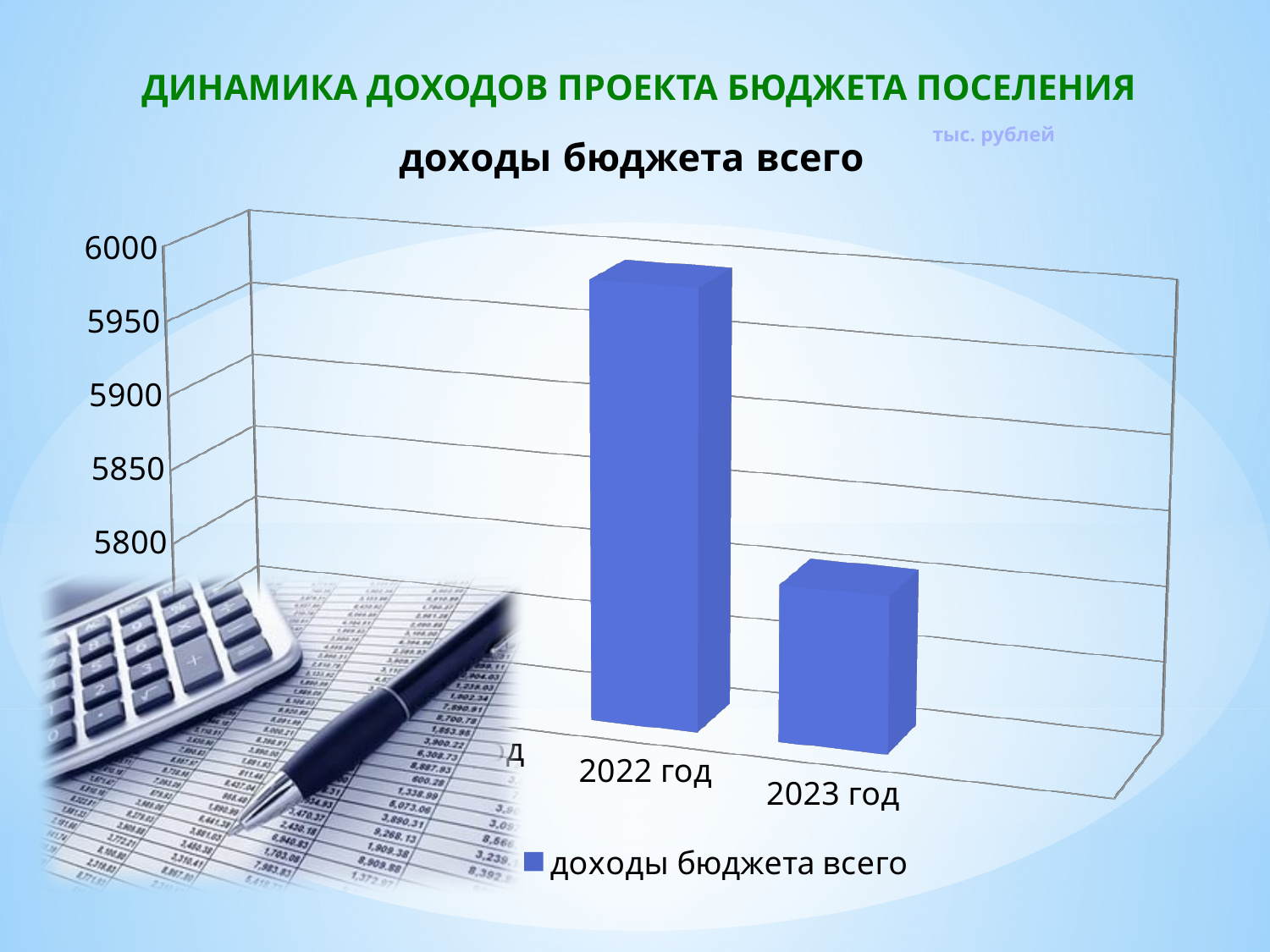
What kind of chart is shown on the slide? bar chart Which is larger, the value for 2022 год or the value for 2023 год? 2022 год How many series does the legend list? 1 What is the highest value shown on the vertical axis? 6000 What is the title of the chart? доходы бюджета всего What is the legend entry of the chart? доходы бюджета всего Do the values rise or fall from 2022 год to 2023 год? fall Is the value for 2023 год greater or less than 5900? less Is the value for 2022 год greater or less than 5900? greater Is the value for 2022 год greater or less than 5950? greater